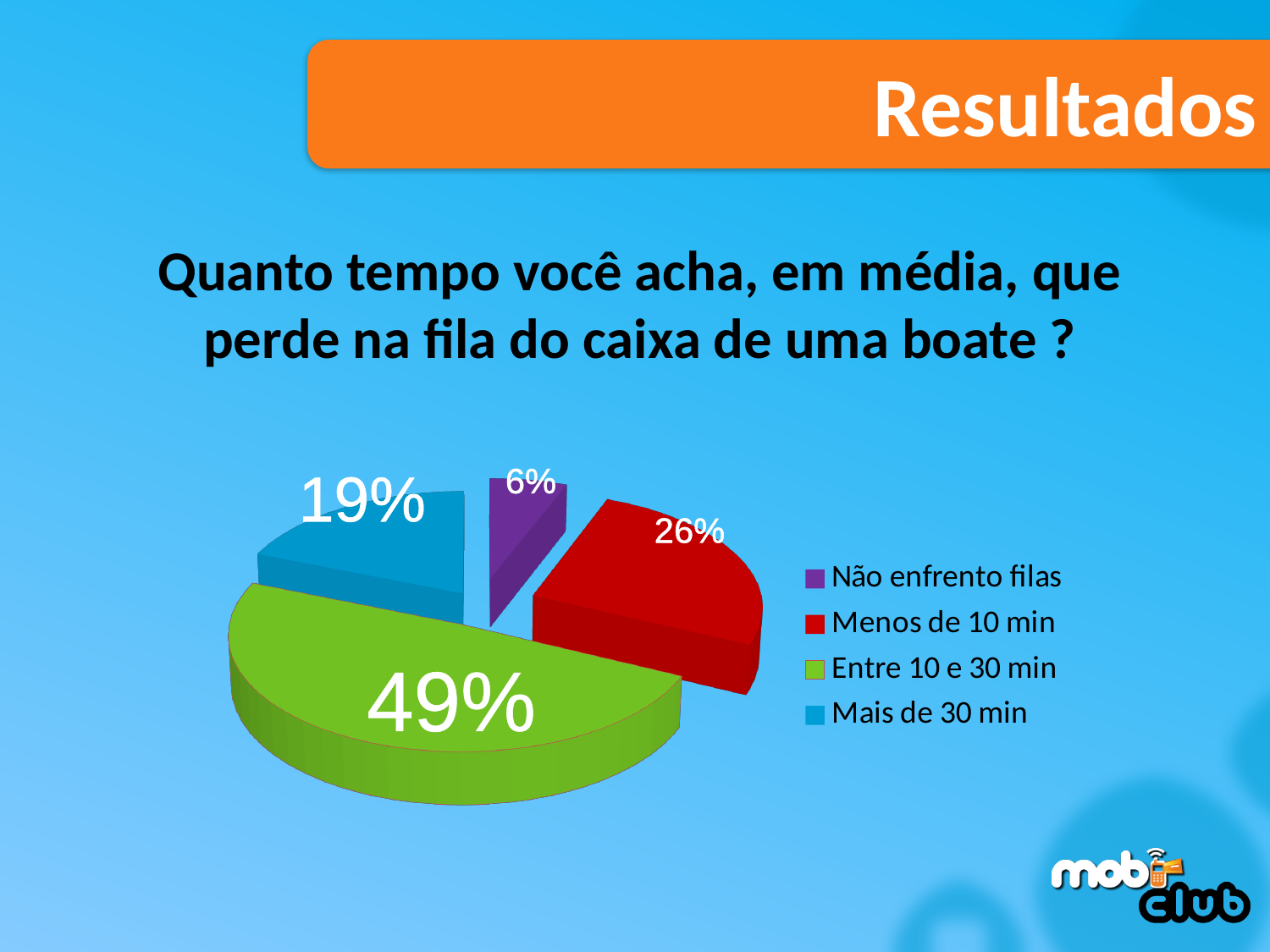
How many categories does the pie chart have? 4 What colour is the slice for "Mais de 30 min"? blue What share of the pie does "Menos de 10 min" have? 26% What share of the pie does "Entre 10 e 30 min" have? 49% What is the difference in percentage points between "Entre 10 e 30 min" and "Menos de 10 min"? 23 What kind of chart is shown on the slide? pie chart Which category has the smallest slice of the pie? Não enfrento filas Which is larger: the slice for "Menos de 10 min" or the slice for "Mais de 30 min"? Menos de 10 min Which category has the largest slice of the pie? Entre 10 e 30 min What share of the pie does "Mais de 30 min" have? 19% What question does the chart present results for? Quanto tempo você acha, em média, que perde na fila do caixa de uma boate ?